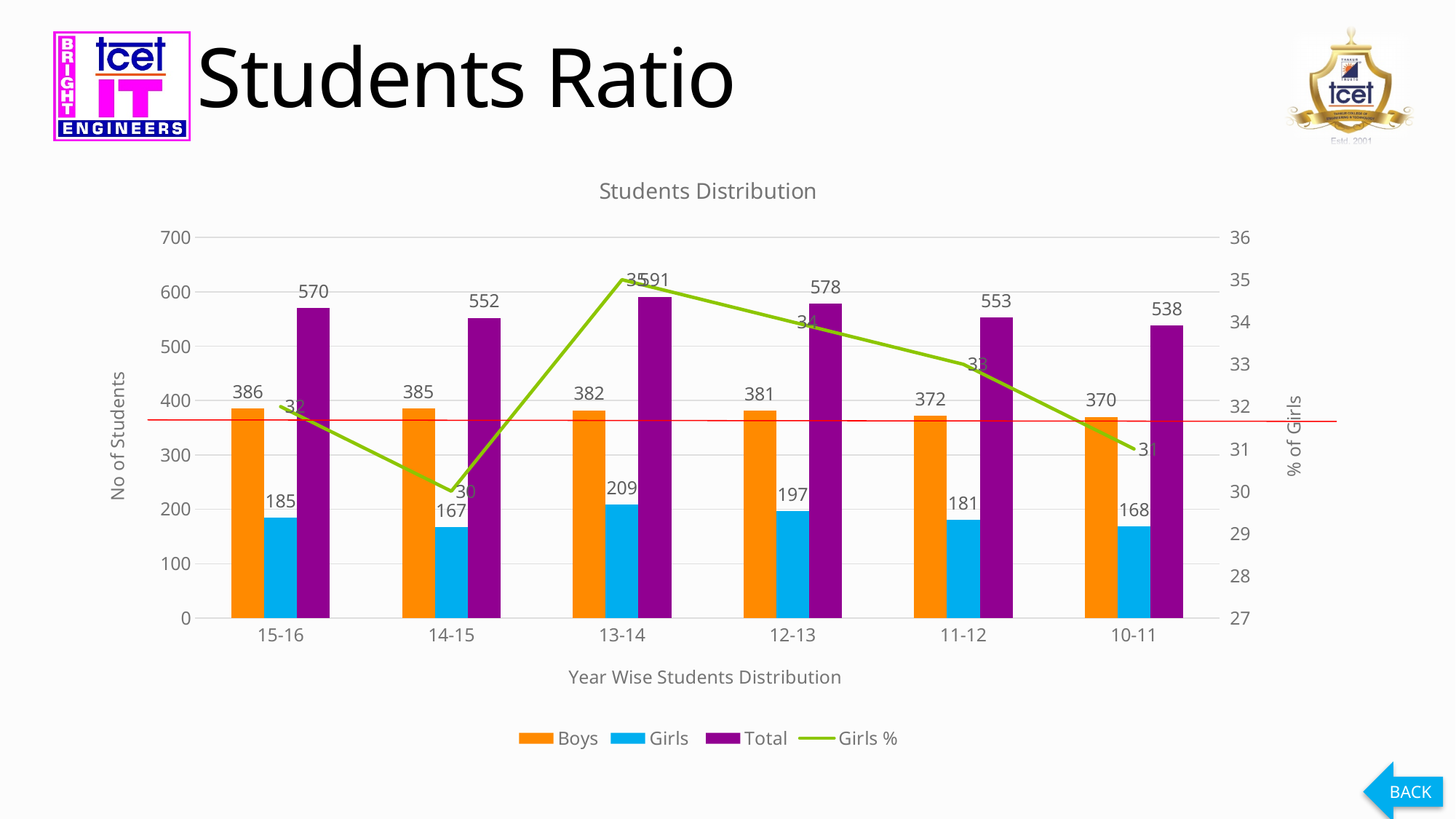
How many series does the legend list? 4 Is the number of Boys in 10-11 greater or less than 300? greater What is the Girls % value for 14-15? 30 Which year has the highest Total? 13-14 Which is larger, the number of Girls in 12-13 or in 11-12? 12-13 How many year categories are shown on the x axis? 6 What is the number of Boys in 15-16? 386 Which year has the lowest number of Girls? 14-15 What is the difference between the Total for 12-13 and the Total for 11-12? 25 What is the title of the chart? Students Distribution What is the Total for 10-11? 538 What is the number of Girls in 13-14? 209